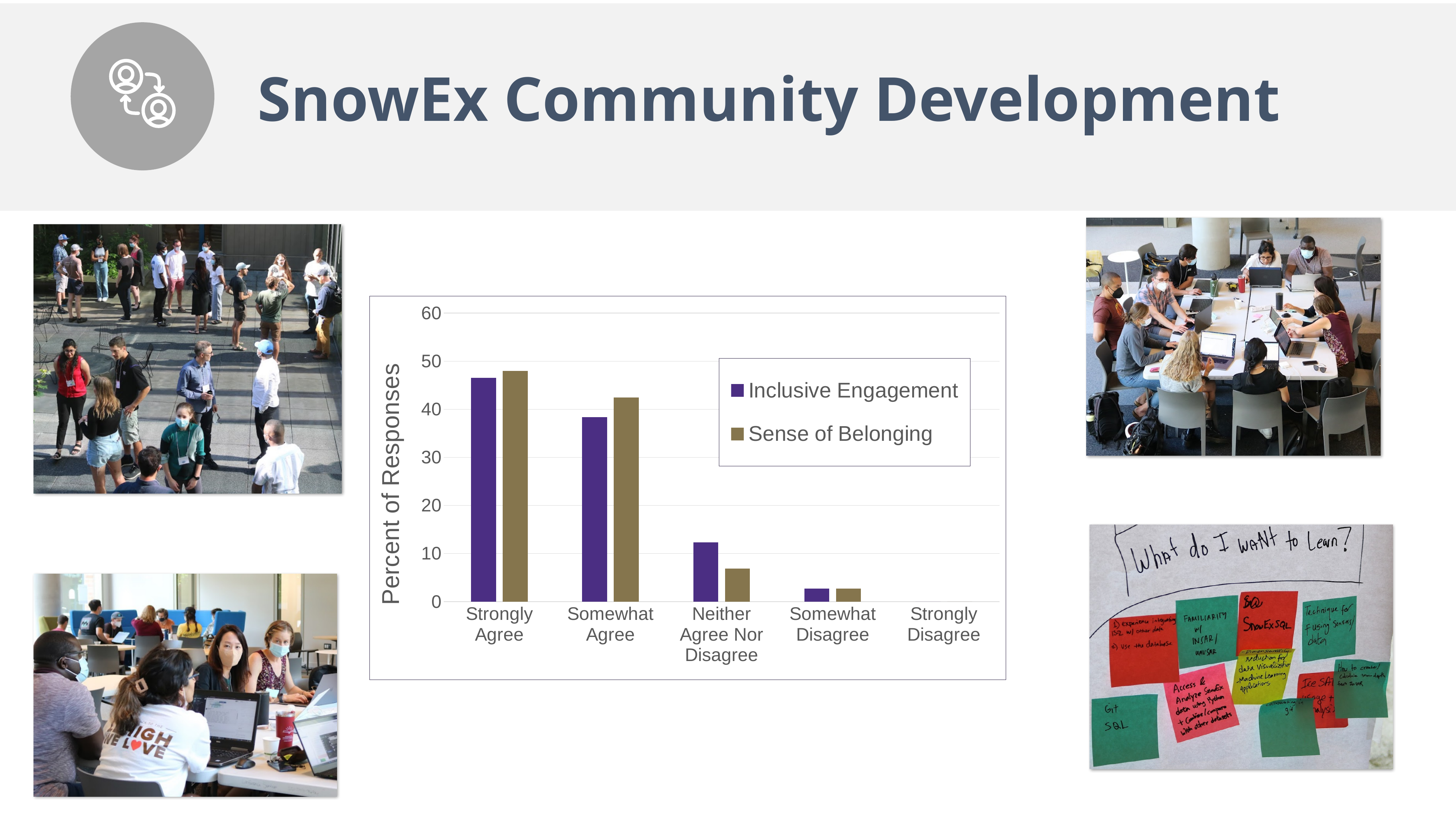
Which response category has the highest value for Sense of Belonging? Strongly Agree Do the Sense of Belonging values rise or fall moving from Strongly Agree to Strongly Disagree along the x axis? fall For Somewhat Agree, which series has the larger value, Inclusive Engagement or Sense of Belonging? Sense of Belonging How many response categories are shown along the x axis of the chart? 5 Is the value for Sense of Belonging at Neither Agree Nor Disagree greater or less than 10? less What is the label on the chart's vertical axis? Percent of Responses For Neither Agree Nor Disagree, which series has the larger value, Inclusive Engagement or Sense of Belonging? Inclusive Engagement Is the value for Inclusive Engagement at Strongly Agree greater or less than 40? greater Which response category has the highest value for Inclusive Engagement? Strongly Agree What kind of chart is shown on the slide? bar chart Which response category has the lowest value for Inclusive Engagement? Strongly Disagree How many series does the chart's legend list? 2